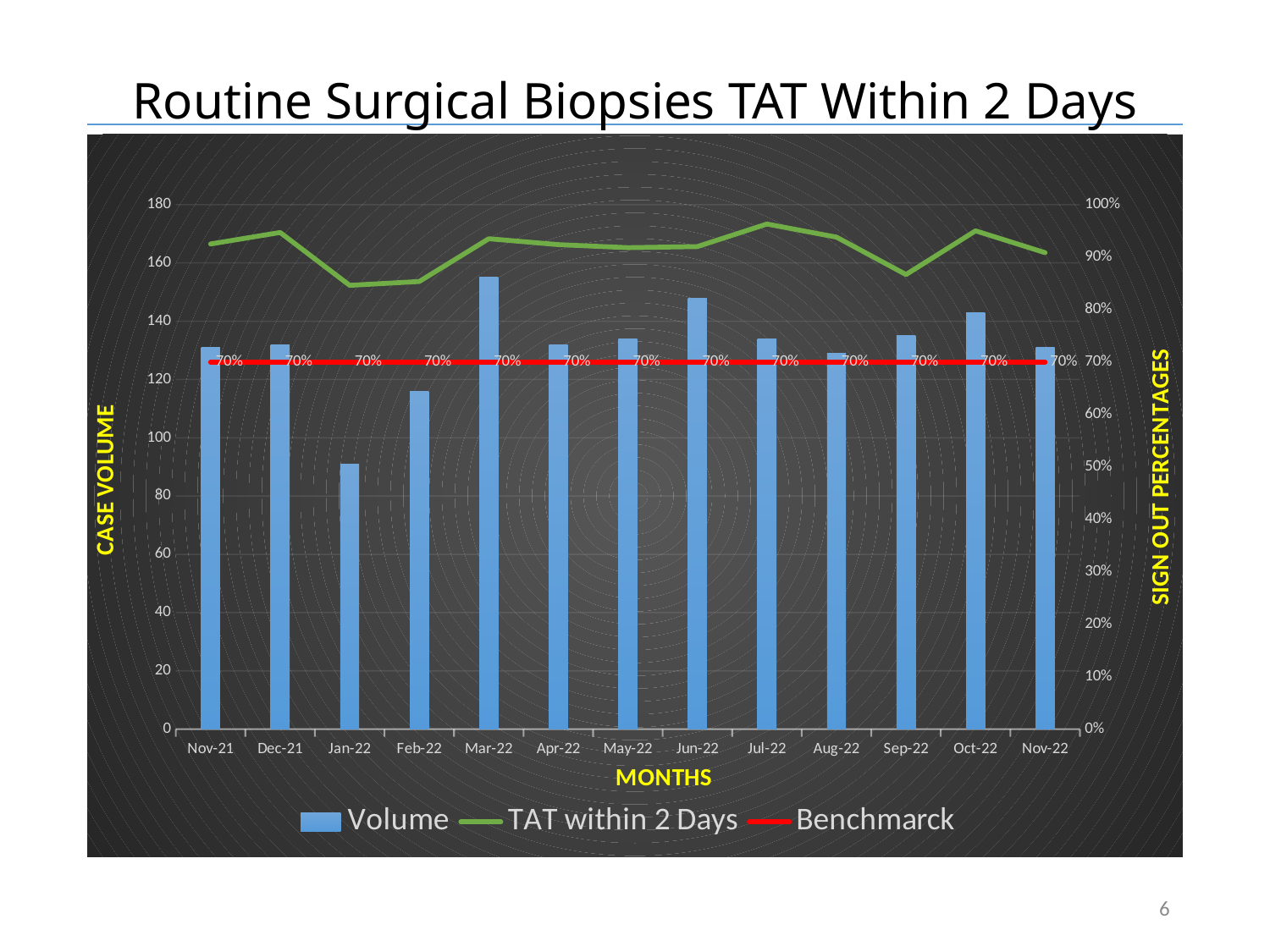
Is the Volume for Mar-22 greater or less than 140? greater What is the label of the right-hand vertical axis? SIGN OUT PERCENTAGES What is the Benchmarck value shown for Jun-22? 70% Which month has the highest Volume bar? Mar-22 Is the TAT within 2 Days value for Jan-22 greater or less than 90%? less What is the title of the chart? Routine Surgical Biopsies TAT Within 2 Days Which month has the larger TAT within 2 Days value, Jul-22 or Sep-22? Jul-22 Is the Volume for Jan-22 greater or less than 100? less What kind of chart is this? Combination bar and line chart How many series does the legend list? 3 How many months are shown on the x axis? 13 Which month has the lowest Volume bar? Jan-22